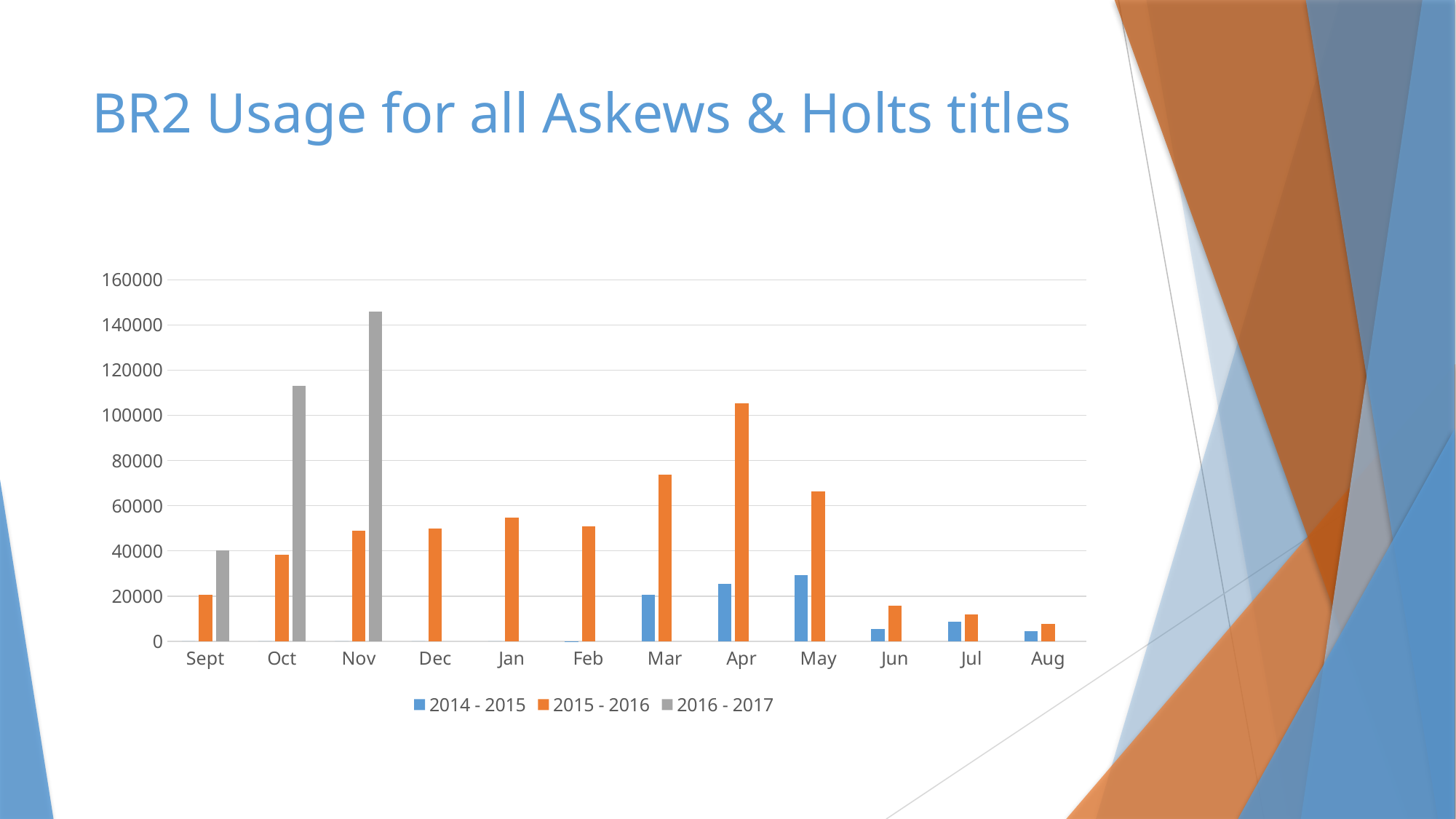
In which month is the 2015 - 2016 value lowest? Aug How many months are shown on the x axis? 12 Do the 2016 - 2017 values rise or fall from Sept to Nov? rise Is the 2015 - 2016 value for Apr greater or less than 100000? greater In which month is the 2015 - 2016 value highest? Apr What kind of chart is shown on the slide? bar chart In which month is the 2014 - 2015 value highest? May For Oct, which series has the larger value, 2015 - 2016 or 2016 - 2017? 2016 - 2017 In which month is the 2016 - 2017 value highest? Nov How many series does the legend list? 3 Is the 2016 - 2017 value for Nov greater or less than 140000? greater What is the title of the slide? BR2 Usage for all Askews & Holts titles